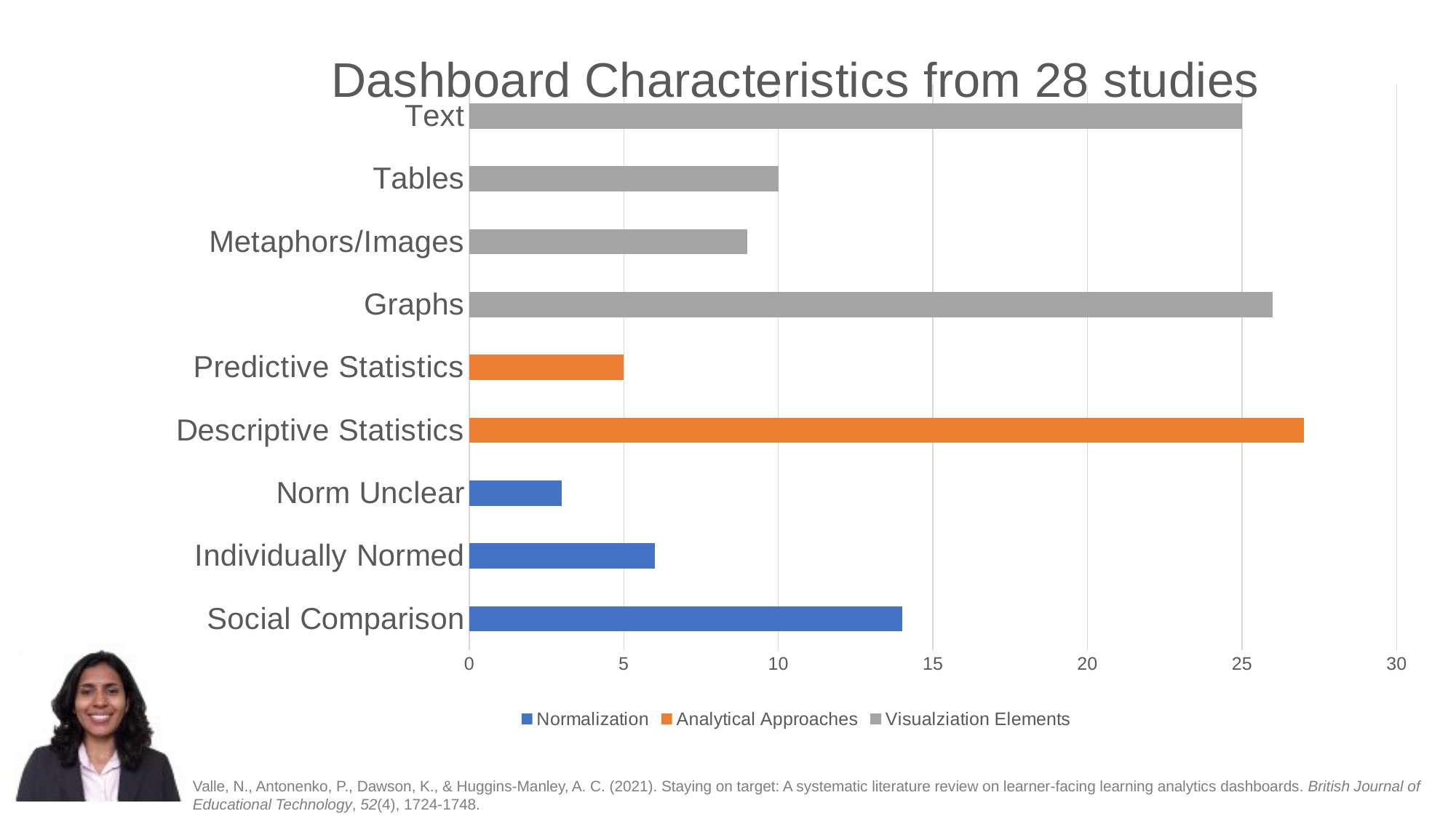
How many series does the legend list? 3 Is the value for Social Comparison greater or less than 15? less What is the value for Tables? 10 What kind of chart is shown on the slide? Bar chart What is the value for Text? 25 Which is larger, the value for Individually Normed or the value for Social Comparison? Social Comparison What is the title of the chart? Dashboard Characteristics from 28 studies How many categories are plotted on the chart? 9 Which category has the highest value? Descriptive Statistics What is the value for Predictive Statistics? 5 Which category has the lowest value? Norm Unclear Which series is shown in orange according to the legend? Analytical Approaches